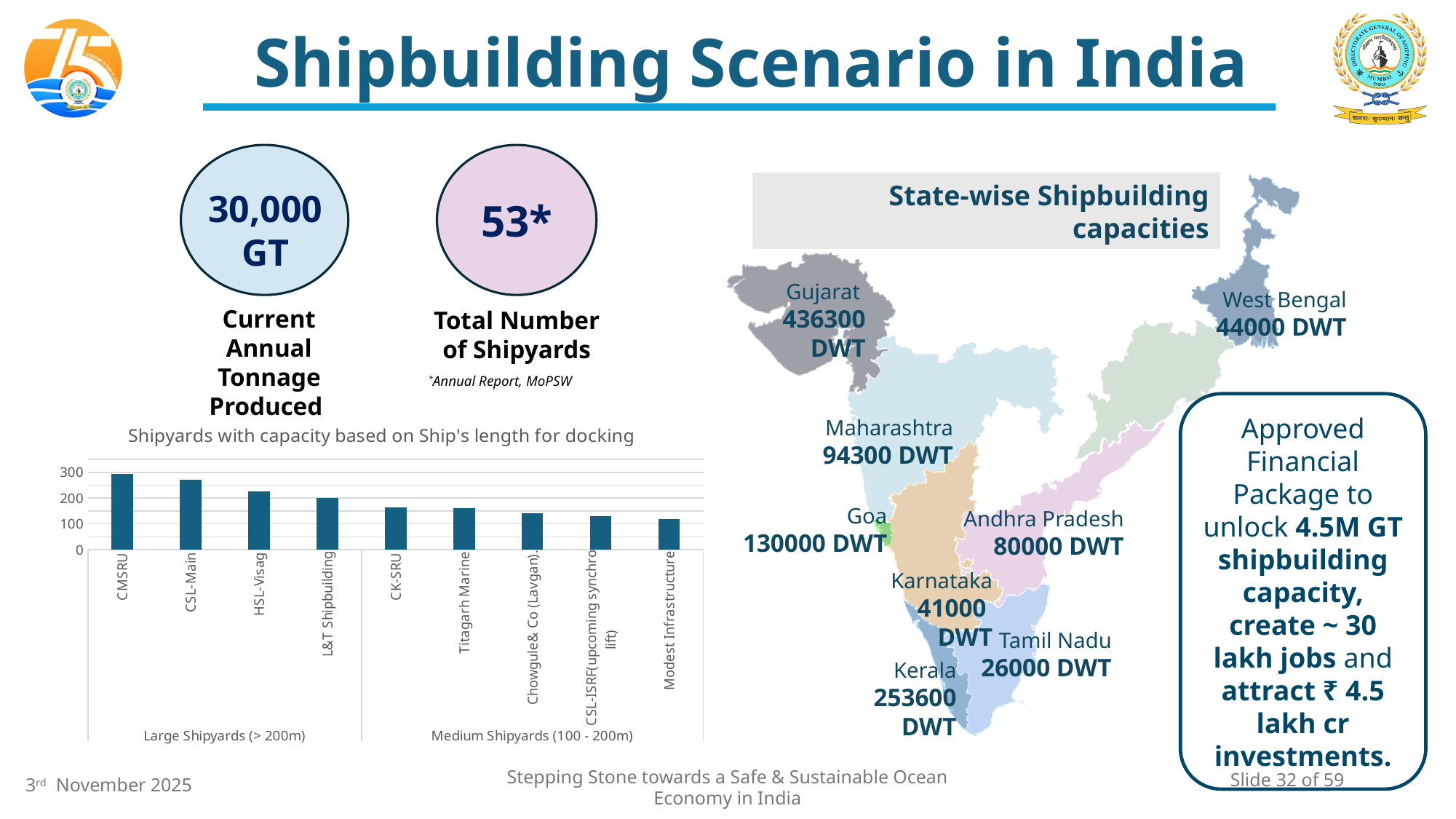
Do the bar values rise or fall from left to right across the chart? fall Is the value for CK-SRU greater or less than 200? less Which has the larger value, CSL-Main or Titagarh Marine? CSL-Main Is the value for CSL-Main greater or less than 200? greater What kind of chart is shown on the slide? bar chart Is the value for Modest Infrastructure greater or less than 200? less How many shipyards are grouped under 'Large Shipyards (> 200m)' in the chart? 4 Which shipyard has the highest bar in the chart? CMSRU What is the title of the bar chart? Shipyards with capacity based on Ship's length for docking How many shipyards are plotted in the bar chart? 9 Which has the larger value, HSL-Visag or Modest Infrastructure? HSL-Visag